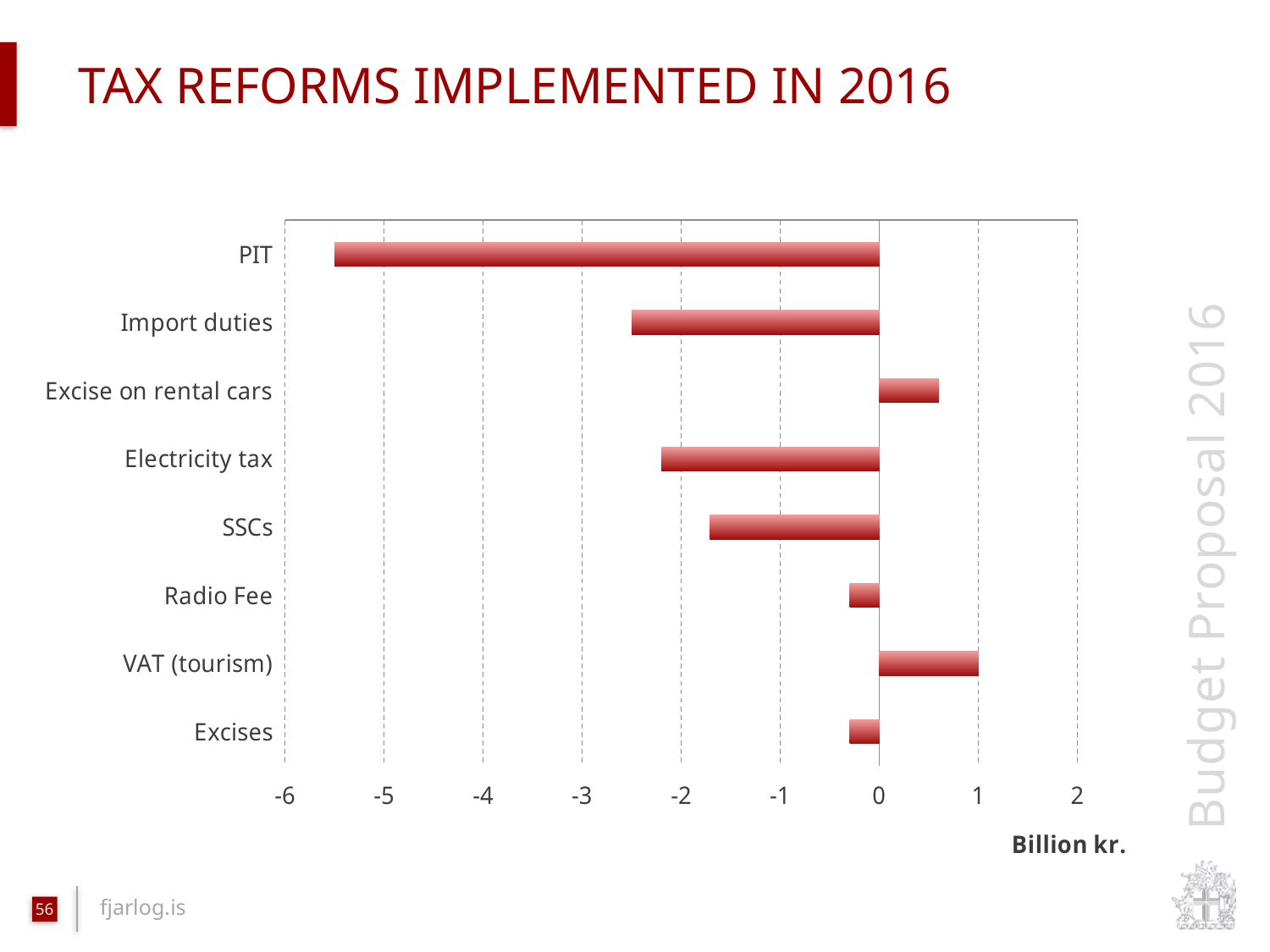
Which has the larger value, Excise on rental cars or VAT (tourism)? VAT (tourism) Which category has the highest value? VAT (tourism) How many categories are plotted in the chart? 8 Is the value for Excise on rental cars greater or less than 0? greater Is the value for Import duties greater or less than -2? less Which category has the lowest (most negative) value? PIT Is the value for Radio Fee greater or less than -1? greater What unit is shown on the x axis of the chart? Billion kr. What kind of chart is shown on the slide? bar chart Which has the larger (less negative) value, PIT or Import duties? Import duties